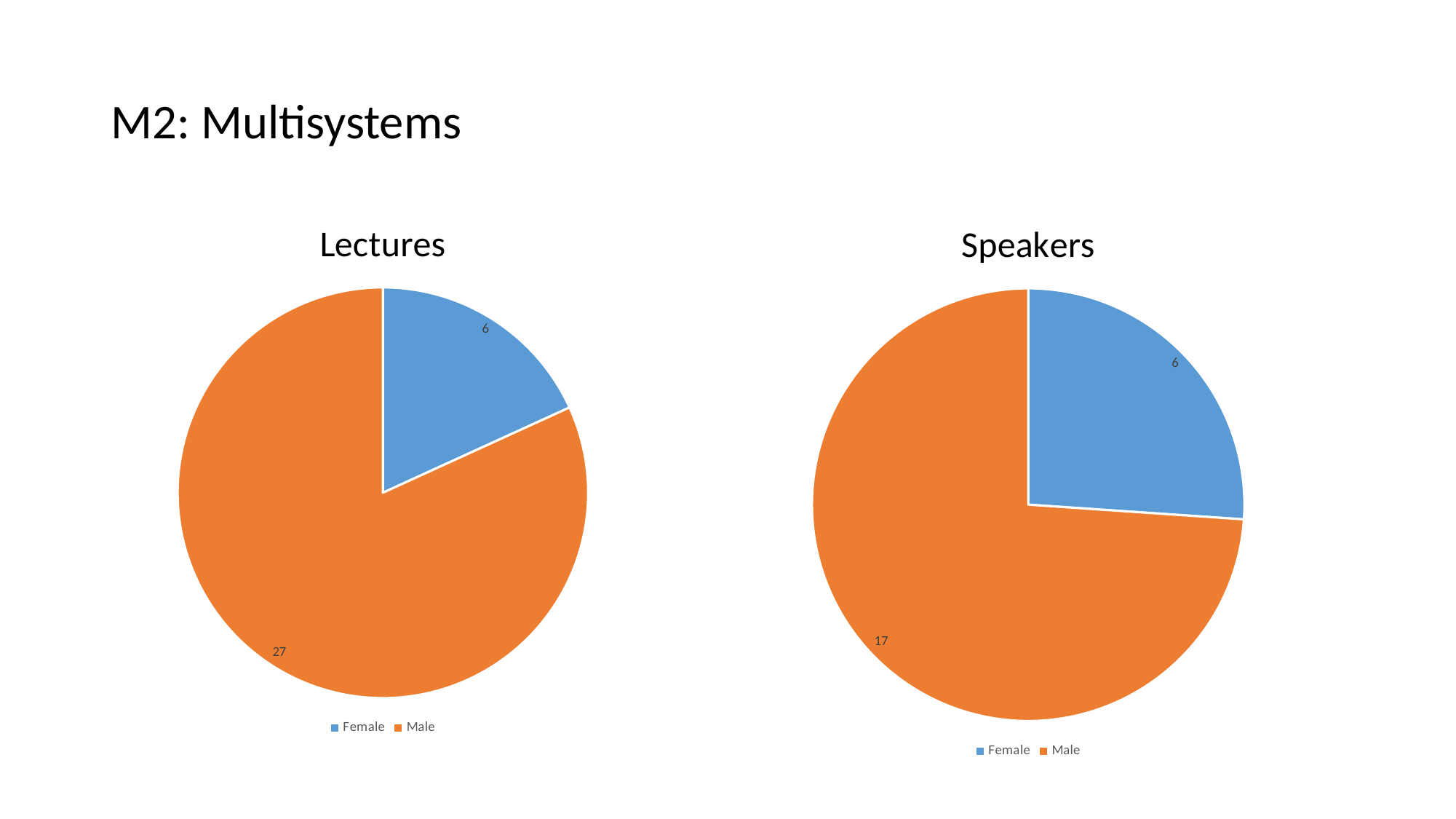
In the Lectures chart, what is the difference between the Male and Female values? 21 In the Lectures chart, what is the value for Male? 27 What is the total of all slices in the Speakers chart? 23 In the Lectures chart, what is the value for Female? 6 Is the Male value larger in the Lectures chart or the Speakers chart? Lectures In the Speakers chart, what is the value for Female? 6 In the Lectures chart, which category has the largest slice? Male What kind of chart is the Lectures chart? Pie chart In the Speakers chart, what is the difference between the Male and Female values? 11 In the Speakers chart, what is the value for Male? 17 How many entries does the legend of the Speakers chart list? 2 In the Speakers chart, which category has the smallest slice? Female